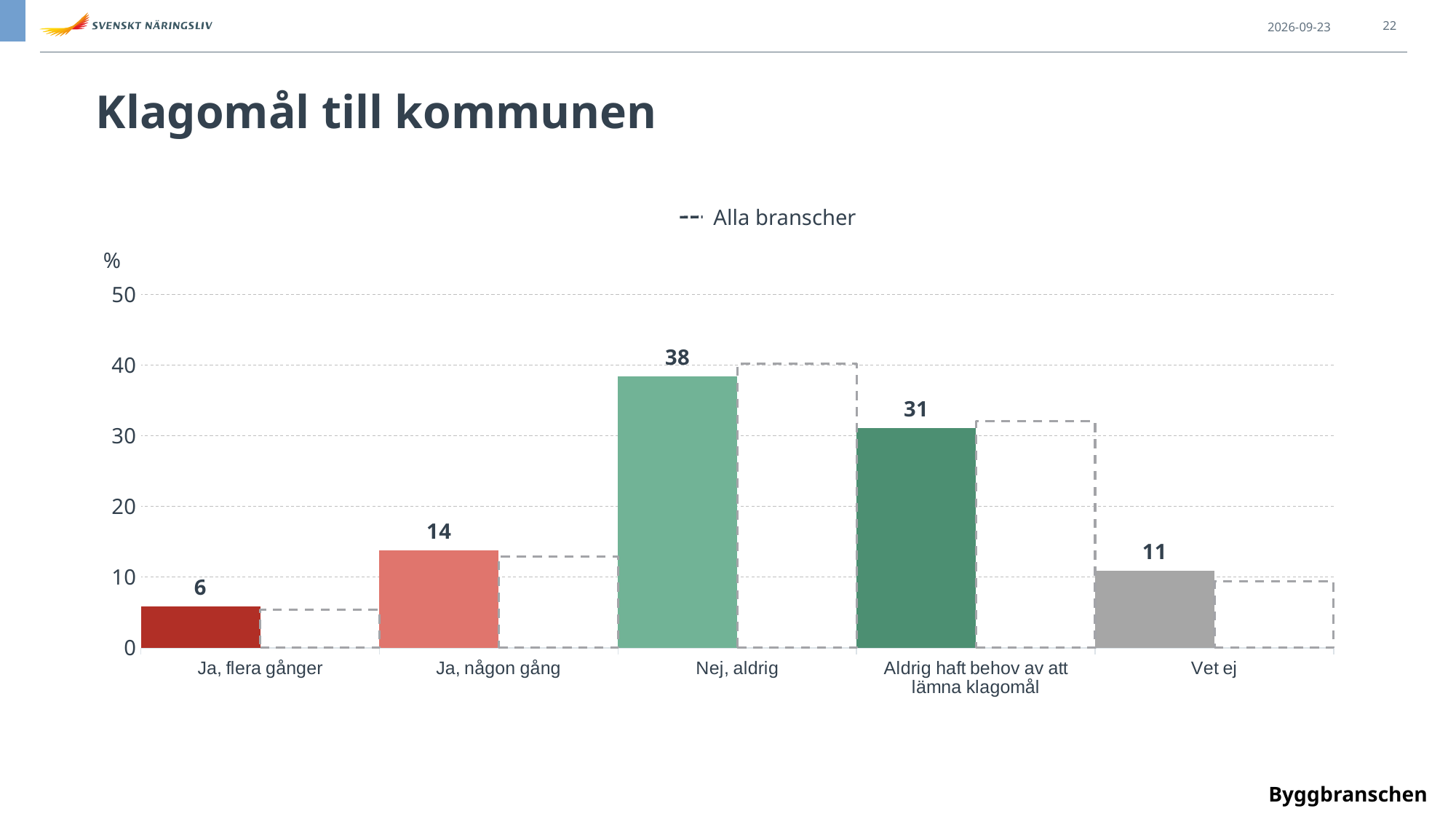
What is the value for "Ja, flera gånger"? 6 What is the value for "Aldrig haft behov av att lämna klagomål"? 31 What is the title of the chart? Klagomål till kommunen What is the value for "Vet ej"? 11 What kind of chart is shown on the slide? Bar chart Which category has the lowest value? Ja, flera gånger What is the value for "Nej, aldrig"? 38 How many categories are shown on the x axis? 5 Is the dashed "Alla branscher" value for "Nej, aldrig" greater or less than 30? greater What is the difference between the values for "Nej, aldrig" and "Aldrig haft behov av att lämna klagomål"? 7 Which category has the highest value? Nej, aldrig Which is larger, the value for "Ja, någon gång" or the value for "Vet ej"? Ja, någon gång